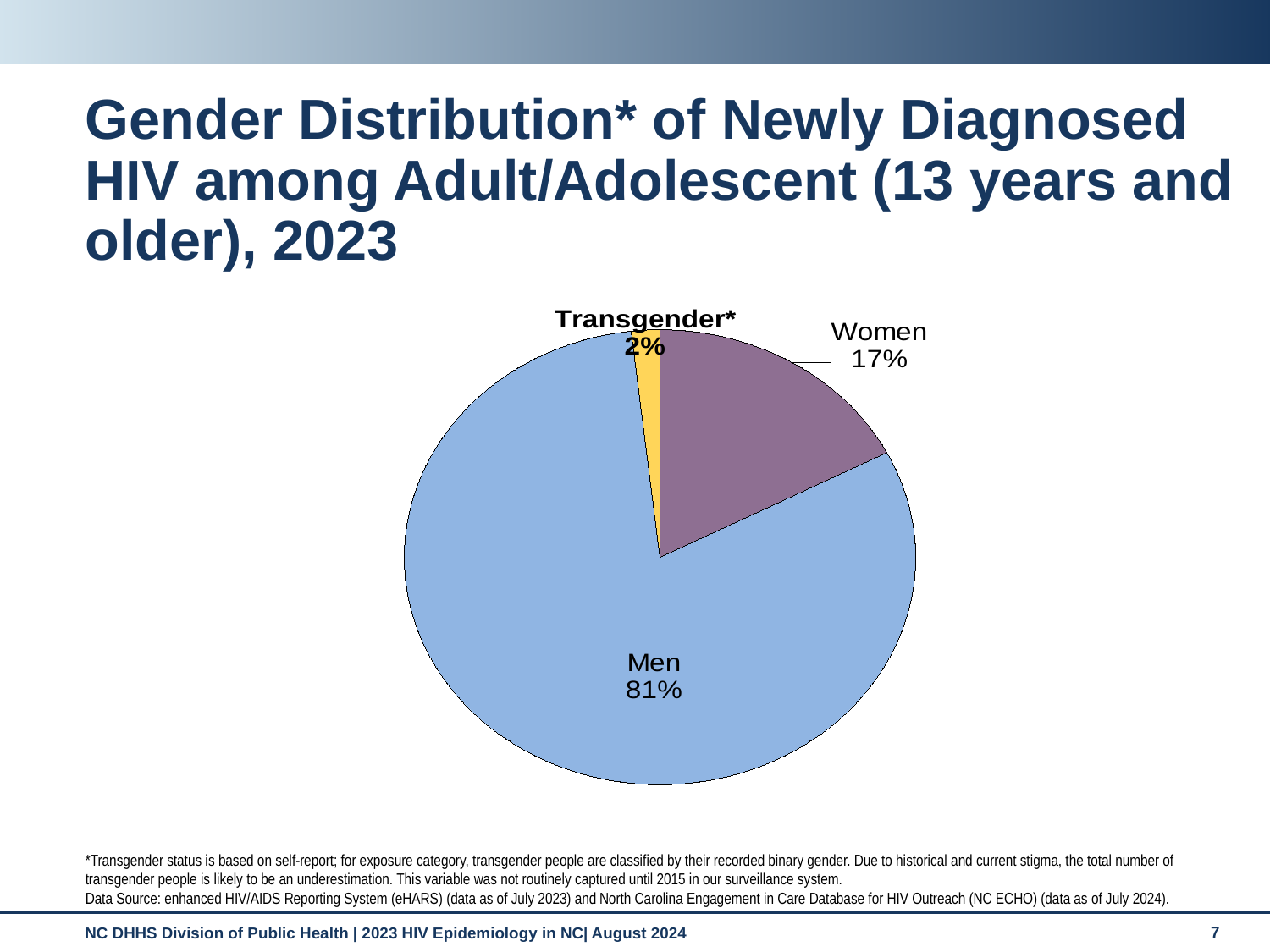
How many categories are shown in the pie chart? 3 What colour is the Men slice of the pie? light blue What share of newly diagnosed HIV cases is shown for Women? 17% What kind of chart is shown on the slide? pie chart Which category has the smallest slice of the pie? Transgender* What share of newly diagnosed HIV cases is shown for Transgender*? 2% What is the difference in percentage points between the Women and Transgender* slices? 15 What is the difference in percentage points between the Men and Women slices? 64 Which slice is larger, Women or Transgender*? Women Which category has the largest slice of the pie? Men What year does the chart title say the data is for? 2023 What share of newly diagnosed HIV cases is shown for Men? 81%